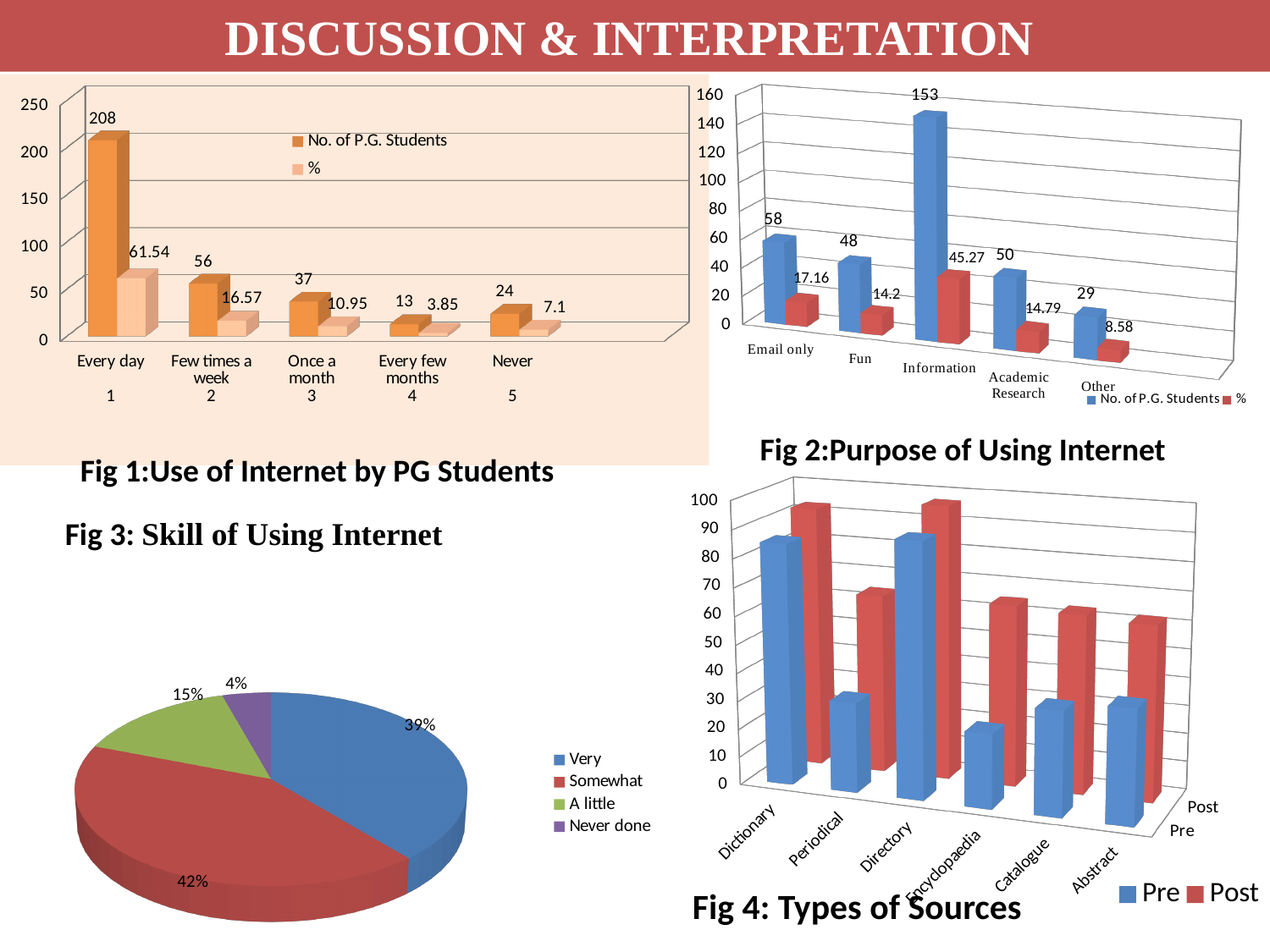
In Fig 2: Purpose of Using Internet, what is the number of P.G. Students for 'Information'? 153 In Fig 2: Purpose of Using Internet, which purpose has the highest number of P.G. Students? Information In Fig 4: Types of Sources, how many series does the legend list? 2 In Fig 1: Use of Internet by PG Students, what is the difference in number of P.G. Students between 'Once a month' and 'Never'? 13 In Fig 3: Skill of Using Internet, what share of the pie is 'Somewhat'? 42% In Fig 3: Skill of Using Internet, which category has the smallest slice? Never done In Fig 1: Use of Internet by PG Students, what is the number of P.G. Students who use the internet every day? 208 In Fig 2: Purpose of Using Internet, what is the % value for 'Other'? 8.58 In Fig 1: Use of Internet by PG Students, what is the % value for 'Few times a week'? 16.57 In Fig 1: Use of Internet by PG Students, which category has the lowest number of P.G. Students? Every few months In Fig 4: Types of Sources, is the Pre value for Periodical greater or less than 50? less In Fig 2: Purpose of Using Internet, which has more P.G. Students, 'Email only' or 'Fun'? Email only